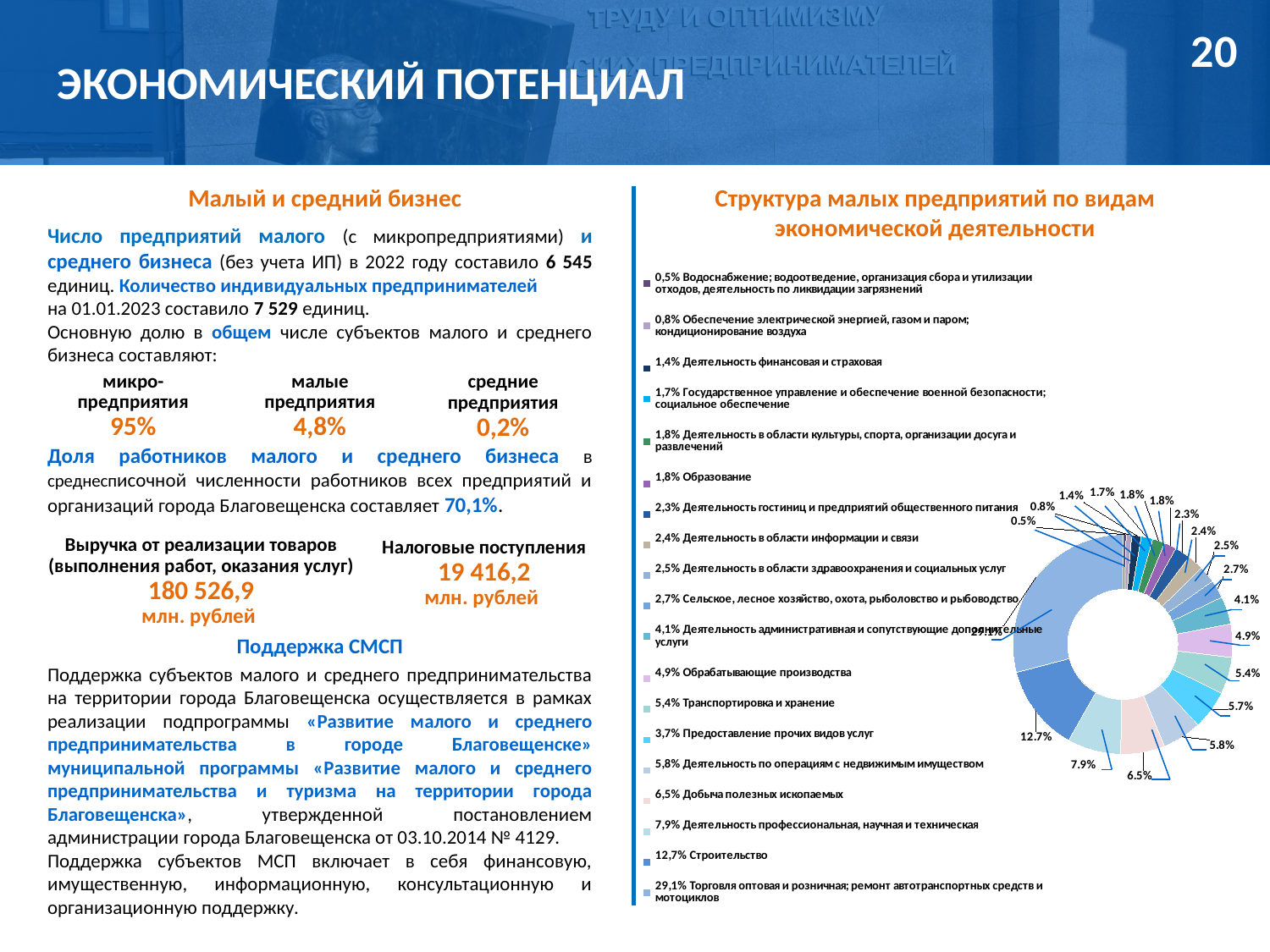
How many types of economic activity are listed in the legend of the chart 'Структура малых предприятий по видам экономической деятельности'? 19 In the chart 'Структура малых предприятий по видам экономической деятельности', how many percentage points larger is the share of 'Торговля оптовая и розничная' than the share of 'Строительство'? 16,4 percentage points What is the title of the chart on the right side of the slide? Структура малых предприятий по видам экономической деятельности In the chart 'Структура малых предприятий по видам экономической деятельности', what share is shown for 'Деятельность профессиональная, научная и техническая'? 7,9% In the chart 'Структура малых предприятий по видам экономической деятельности', what share is shown for 'Строительство'? 12,7% In the chart 'Структура малых предприятий по видам экономической деятельности', which type of activity has the largest share? Торговля оптовая и розничная; ремонт автотранспортных средств и мотоциклов (29,1%) In the chart 'Структура малых предприятий по видам экономической деятельности', what is the difference between the shares of 'Строительство' and 'Деятельность профессиональная, научная и техническая'? 4,8 percentage points In the chart 'Структура малых предприятий по видам экономической деятельности', which type of activity has the smallest share? Водоснабжение; водоотведение, организация сбора и утилизации отходов, деятельность по ликвидации загрязнений (0,5%) In the chart 'Структура малых предприятий по видам экономической деятельности', what share is shown for 'Образование'? 1,8% In the chart 'Структура малых предприятий по видам экономической деятельности', which has the larger share: 'Транспортировка и хранение' or 'Обрабатывающие производства'? Транспортировка и хранение What kind of chart is used to show the structure of small enterprises by type of economic activity? Pie (doughnut) chart In the chart 'Структура малых предприятий по видам экономической деятельности', what share is shown for 'Добыча полезных ископаемых'? 6,5%